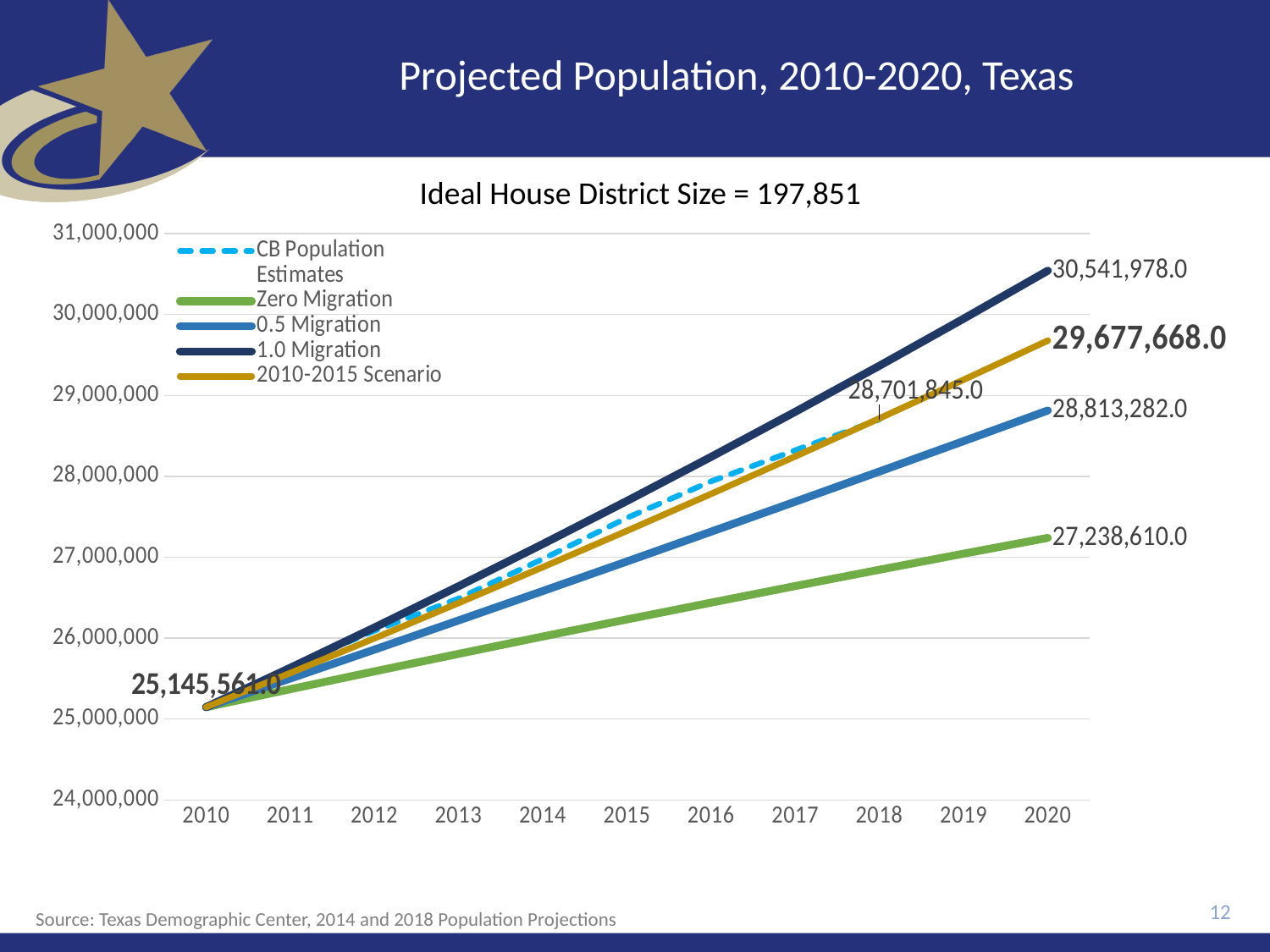
How many years are shown on the x axis? 11 What is the projected population for the 2010-2015 Scenario series in 2020? 29,677,668.0 Which series has the lowest value in 2020? Zero Migration What is the projected population for the 0.5 Migration series in 2020? 28,813,282.0 What type of chart is shown on the slide? line chart What is the projected population for the Zero Migration series in 2020? 27,238,610.0 What is the starting population value shown for 2010? 25,145,561.0 Which series has the highest value in 2020? 1.0 Migration How many series does the legend list? 5 What is the projected population for the 1.0 Migration series in 2020? 30,541,978.0 Is the value for the 2010-2015 Scenario series in 2015 greater or less than 27,000,000? greater What is the difference between the 1.0 Migration and Zero Migration values in 2020? 3,303,368.0